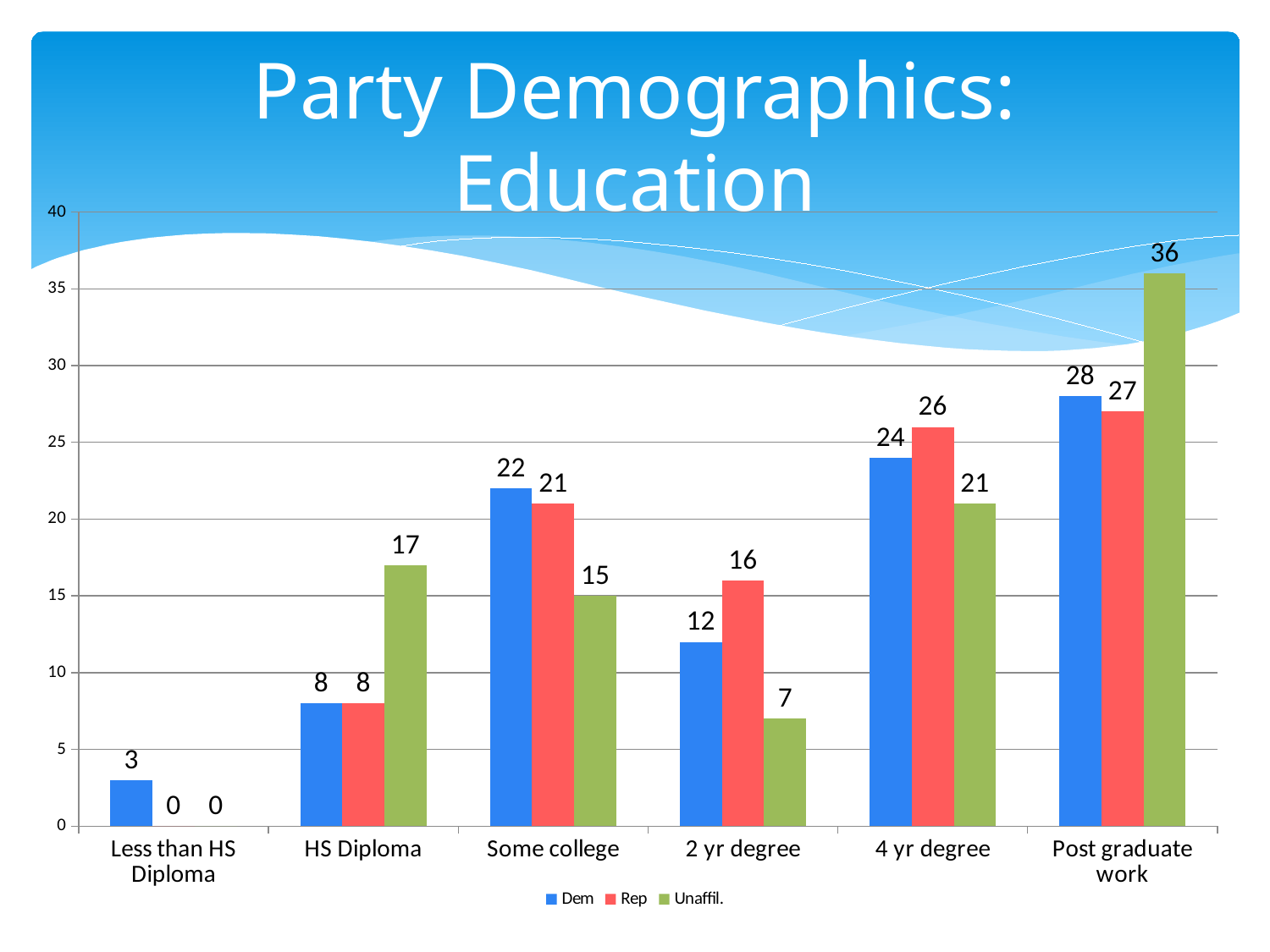
How many education categories are shown on the x axis? 6 What is the value for Unaffil. in the Post graduate work category? 36 What is the value for Rep in the 2 yr degree category? 16 What is the title of the chart? Party Demographics: Education What is the difference between the Rep and Unaffil. values for 4 yr degree? 5 Is the Dem value for Post graduate work greater or less than 25? greater Which category has the highest Unaffil. value? Post graduate work How many series does the legend list? 3 What is the value for Dem in the Some college category? 22 Which category has the lowest Dem value? Less than HS Diploma What kind of chart is shown on the slide? bar chart Which is larger for HS Diploma: the Dem value or the Unaffil. value? Unaffil.